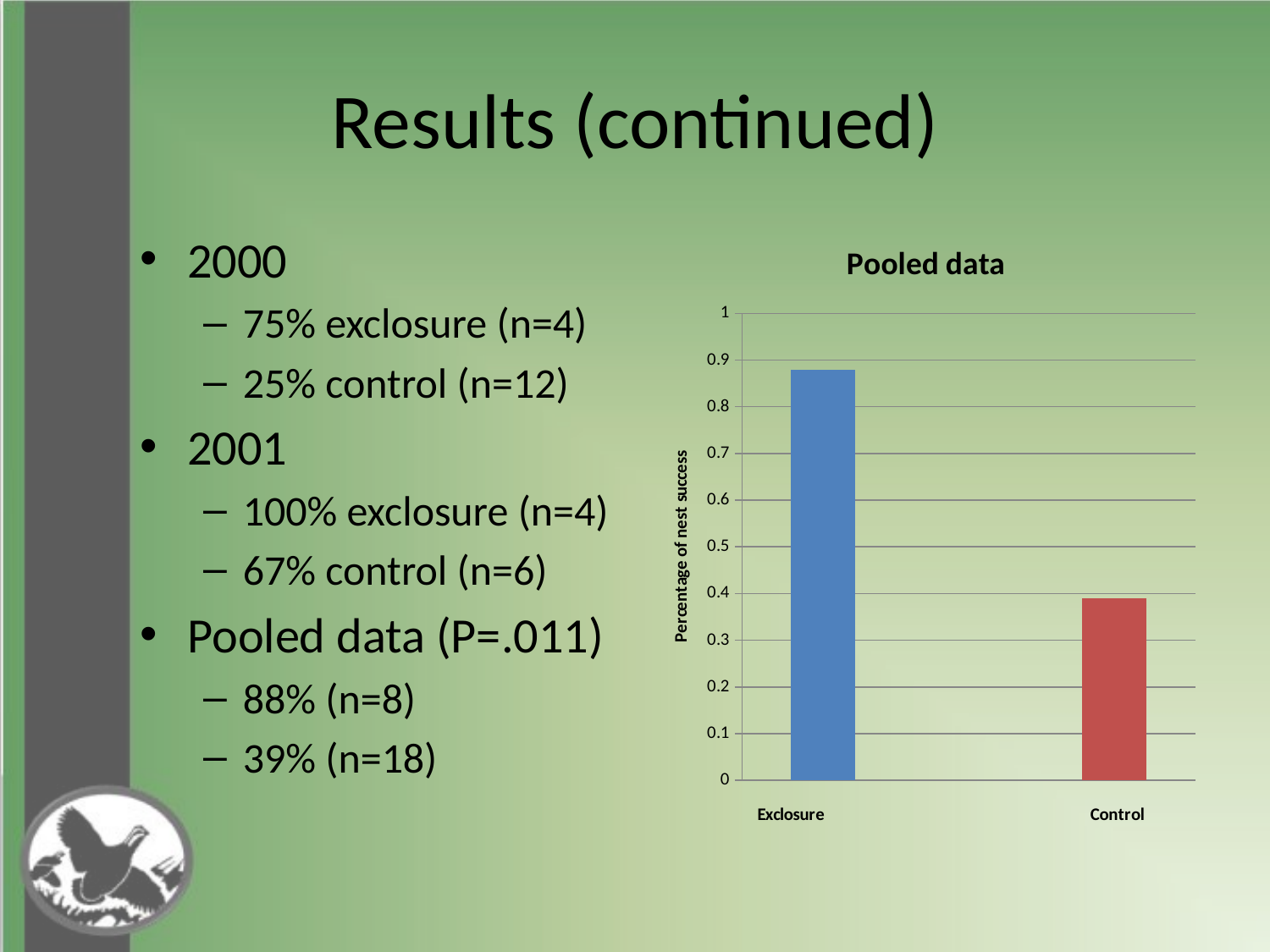
Which category has the highest value in the chart? Exclosure Do the values fall or rise going from Exclosure to Control along the x axis? fall What is the label of the vertical axis of the chart? Percentage of nest success What kind of chart is shown on the slide? bar chart What is the title of the chart? Pooled data Is the value for Control greater or less than 0.5? less Which is larger, the value for Exclosure or the value for Control? Exclosure Is the value for Exclosure greater or less than 0.8? greater Is the value for Exclosure greater or less than 0.9? less How many categories are plotted in the chart? 2 Which category has the lowest value in the chart? Control